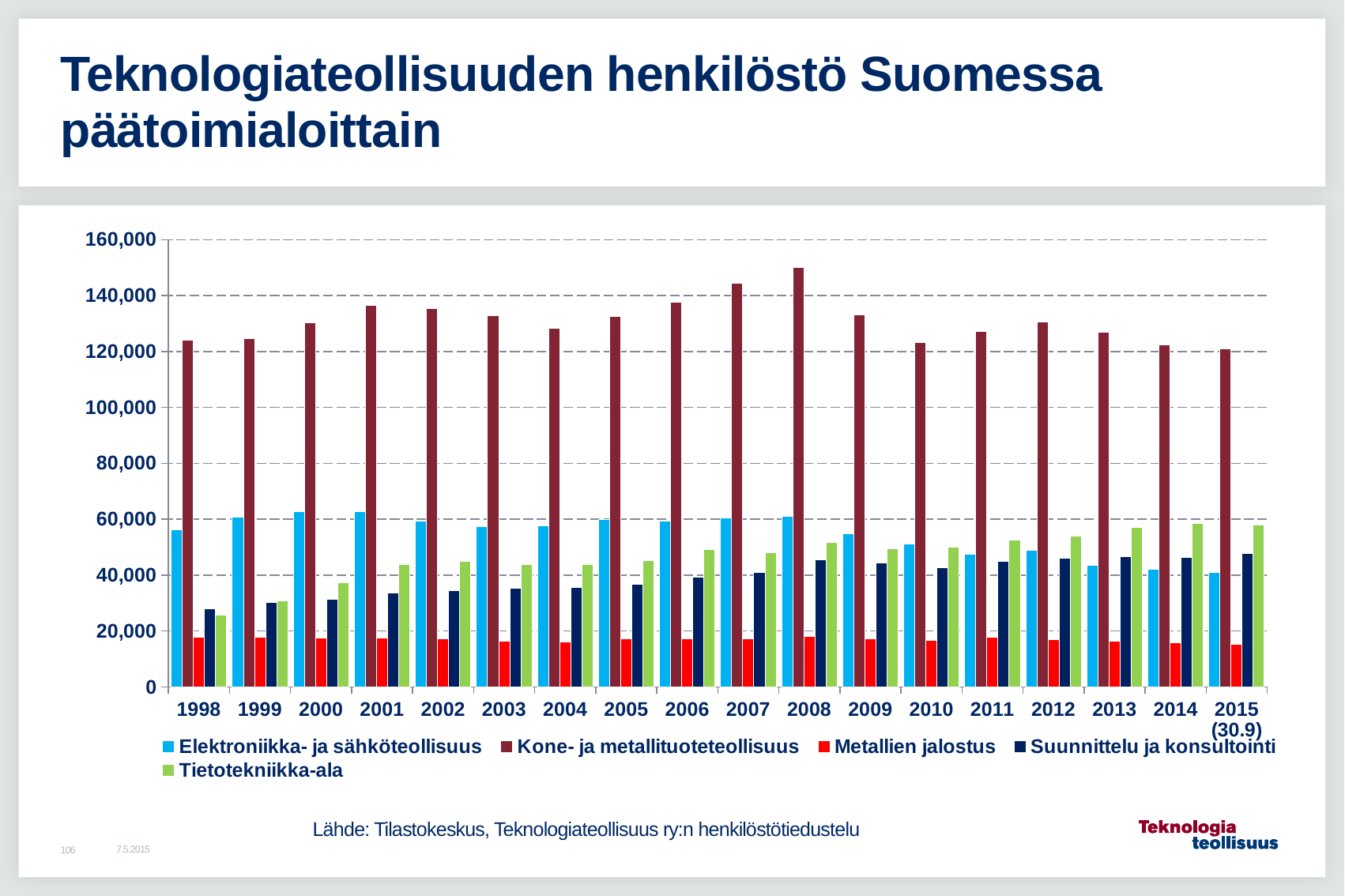
Is the value for Metallien jalostus in 2008 greater or less than 20,000? less What kind of chart is shown on the slide? Bar chart Is the value for Kone- ja metallituoteteollisuus in 2008 greater or less than 140,000? greater How many series does the legend list? 5 In 2015, which is larger: Tietotekniikka-ala or Elektroniikka- ja sähköteollisuus? Tietotekniikka-ala Which colour represents Metallien jalostus in the chart? Red In which year is the value for Kone- ja metallituoteteollisuus highest? 2008 Is the value for Suunnittelu ja konsultointi in 2015 greater or less than 40,000? greater In which year is the value for Tietotekniikka-ala lowest? 1998 In which year is the value for Suunnittelu ja konsultointi lowest? 1998 How many years are shown on the x axis? 18